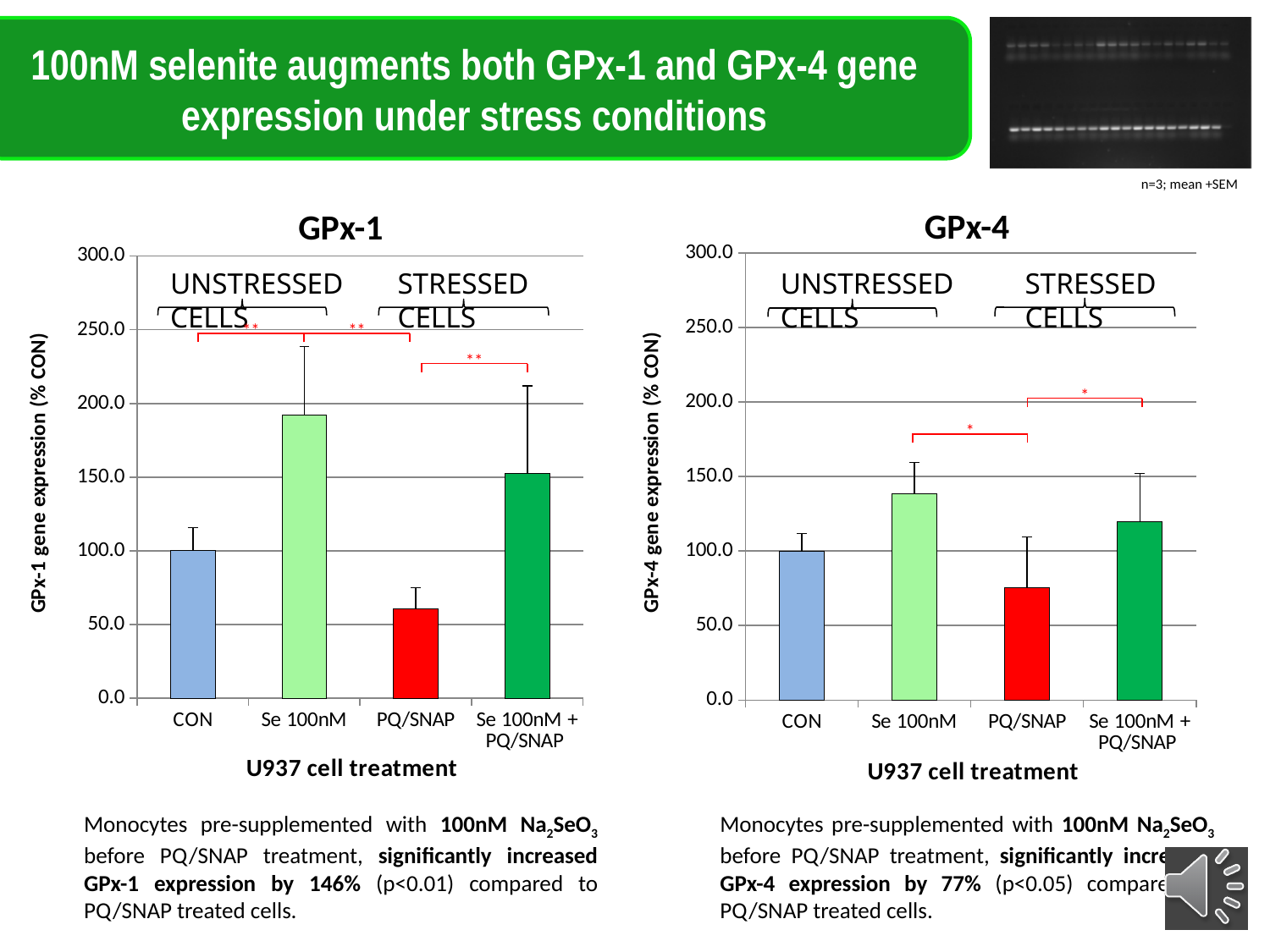
How many treatment categories are shown on the x axis of the GPx-4 chart? 4 What is the x-axis title of the GPx-4 chart? U937 cell treatment What kind of chart is the GPx-1 chart? bar chart In the GPx-1 chart, which treatment has the lowest gene expression? PQ/SNAP In the GPx-4 chart, which is larger: the value for Se 100nM + PQ/SNAP or the value for PQ/SNAP? Se 100nM + PQ/SNAP In the GPx-1 chart, which treatment has the highest gene expression? Se 100nM In the GPx-1 chart, what is the gene expression value for CON? 100.0 In the GPx-4 chart, is the value for Se 100nM + PQ/SNAP greater or less than 150.0? less In the GPx-1 chart, is the value for Se 100nM greater or less than 150.0? greater In the GPx-1 chart, is the value for PQ/SNAP greater or less than 100.0? less In the GPx-4 chart, which treatment has the lowest gene expression? PQ/SNAP In the GPx-4 chart, which treatment has the highest gene expression? Se 100nM